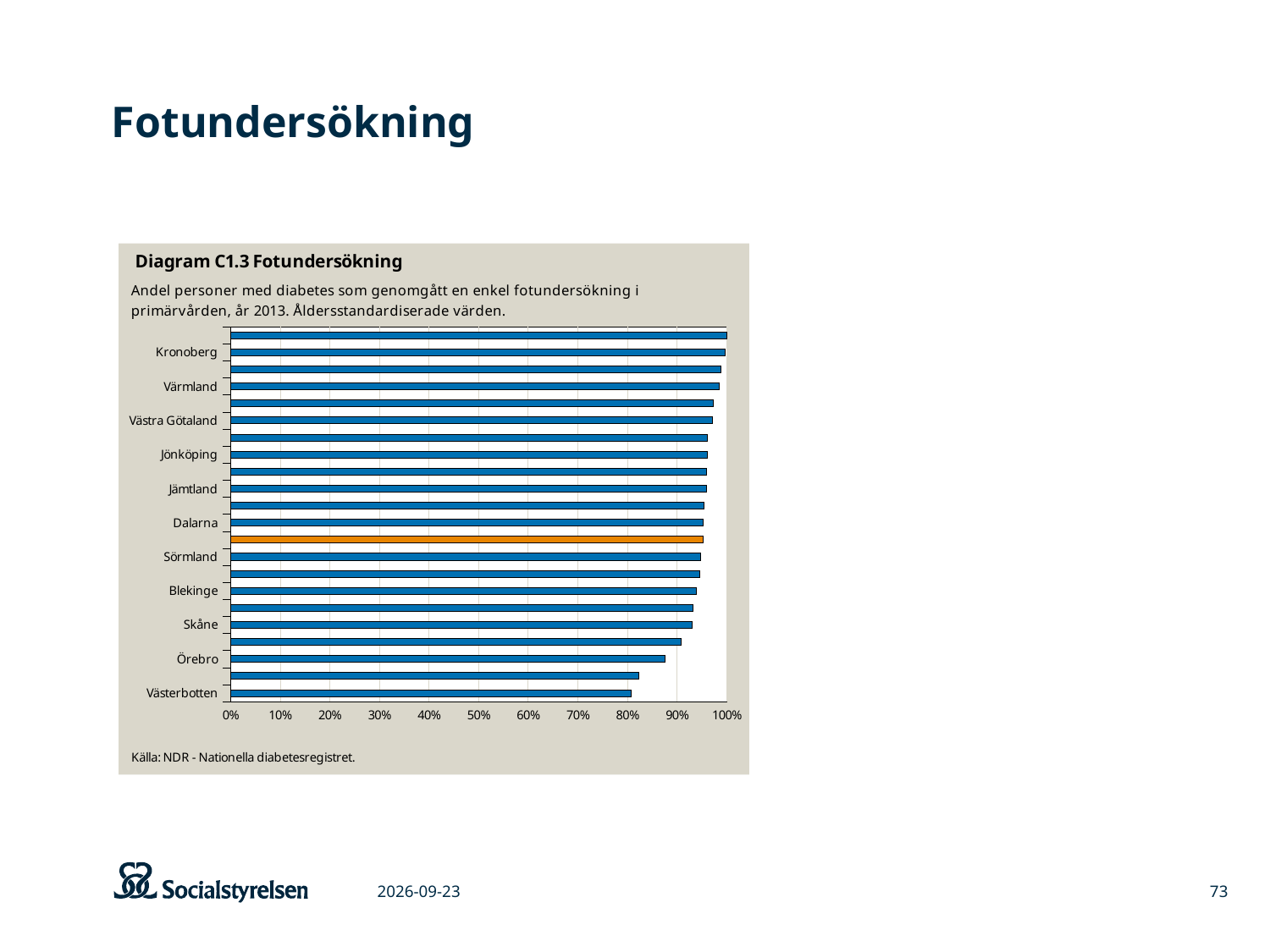
Which has the larger value, Värmland or Örebro? Värmland What source is cited below the chart? NDR - Nationella diabetesregistret Which region has the lowest value in the chart? Västerbotten Is the value for Örebro greater or less than 80%? greater Is the value for Skåne greater or less than 80%? greater Which has the larger value, Kronoberg or Västerbotten? Kronoberg How many bars are plotted in the chart? 22 What kind of chart is shown on the slide? Bar chart Is the value for Kronoberg greater or less than 90%? greater What is the title of the diagram? Diagram C1.3 Fotundersökning Do the bar values increase or decrease going from the top of the chart to the bottom? Decrease